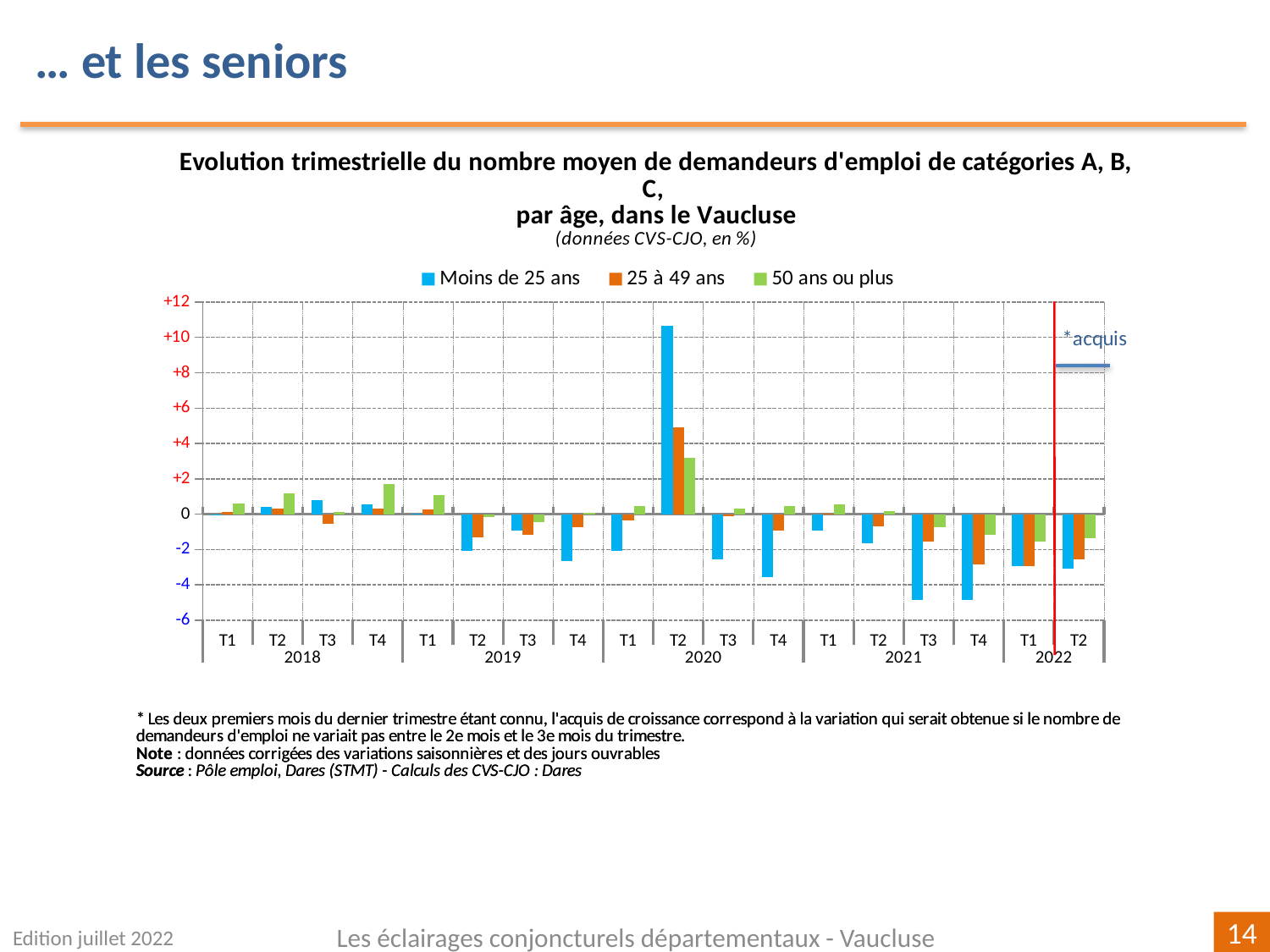
Which series are listed in the legend? Moins de 25 ans, 25 à 49 ans, 50 ans ou plus Is the value for 'Moins de 25 ans' in T4 2020 greater or less than -2? less What kind of chart is shown on the slide? bar chart Is the value for 'Moins de 25 ans' in T2 2020 greater or less than +10? greater How many quarters are shown along the x axis? 18 Is the value for '25 à 49 ans' in T2 2020 greater or less than +4? greater How many series does the legend list? 3 In T4 2021, which of the three series has the lowest value? Moins de 25 ans In T2 2020, which series has the larger value: 'Moins de 25 ans' or '25 à 49 ans'? Moins de 25 ans In which quarter does the 'Moins de 25 ans' series reach its highest value? T2 2020